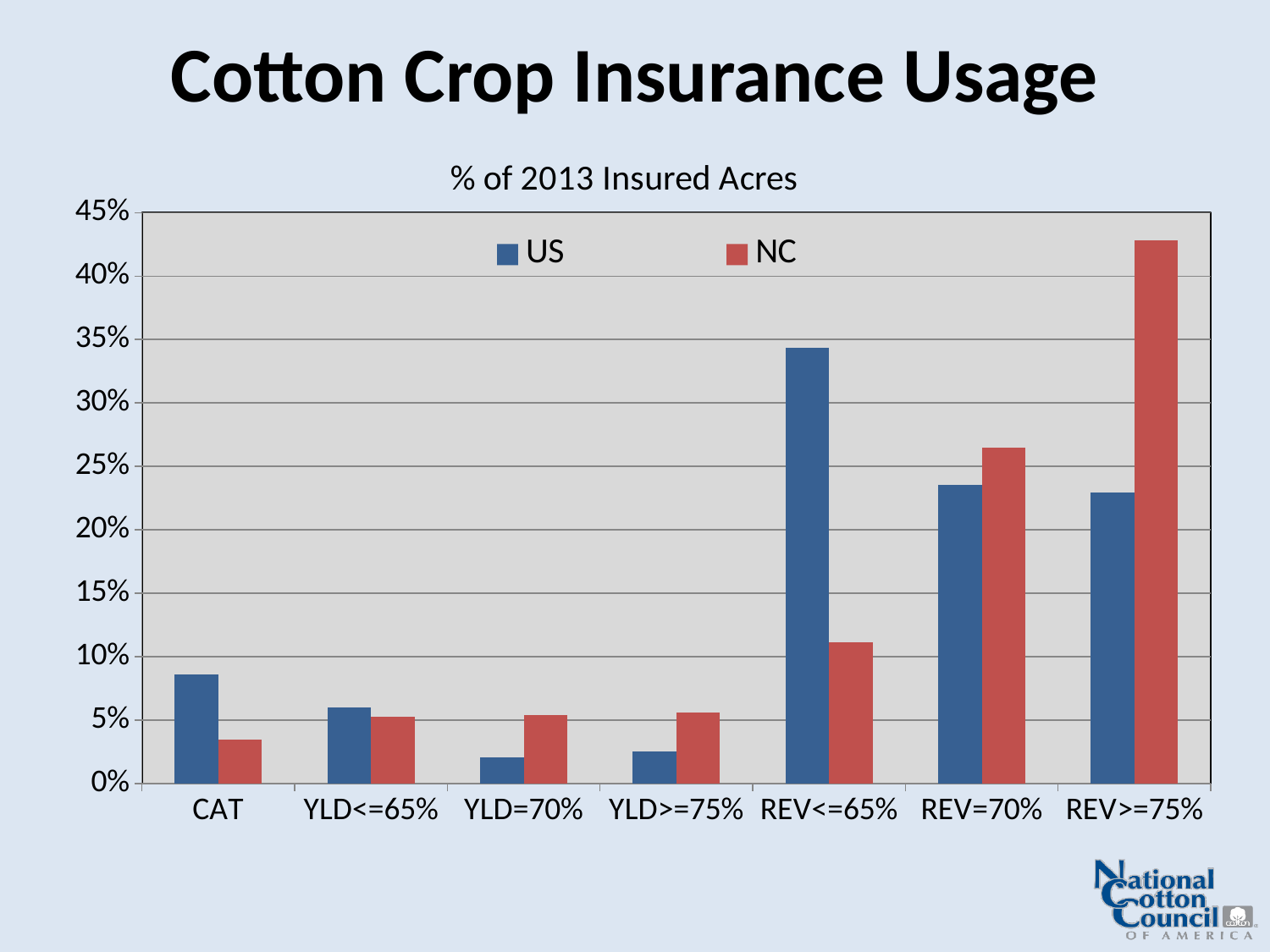
Which category has the lowest NC value? CAT For REV<=65%, which is larger, the US value or the NC value? US What is the subtitle shown above the chart? % of 2013 Insured Acres Is the US value for REV<=65% greater or less than 30%? greater Is the NC value for CAT greater or less than 5%? less How many categories are shown on the x axis? 7 How many series does the legend list? 2 Is the NC value for REV>=75% greater or less than 40%? greater Which category has the highest US value? REV<=65% For YLD=70%, which is larger, the US value or the NC value? NC Which category has the highest NC value? REV>=75% What kind of chart is shown on the slide? bar chart